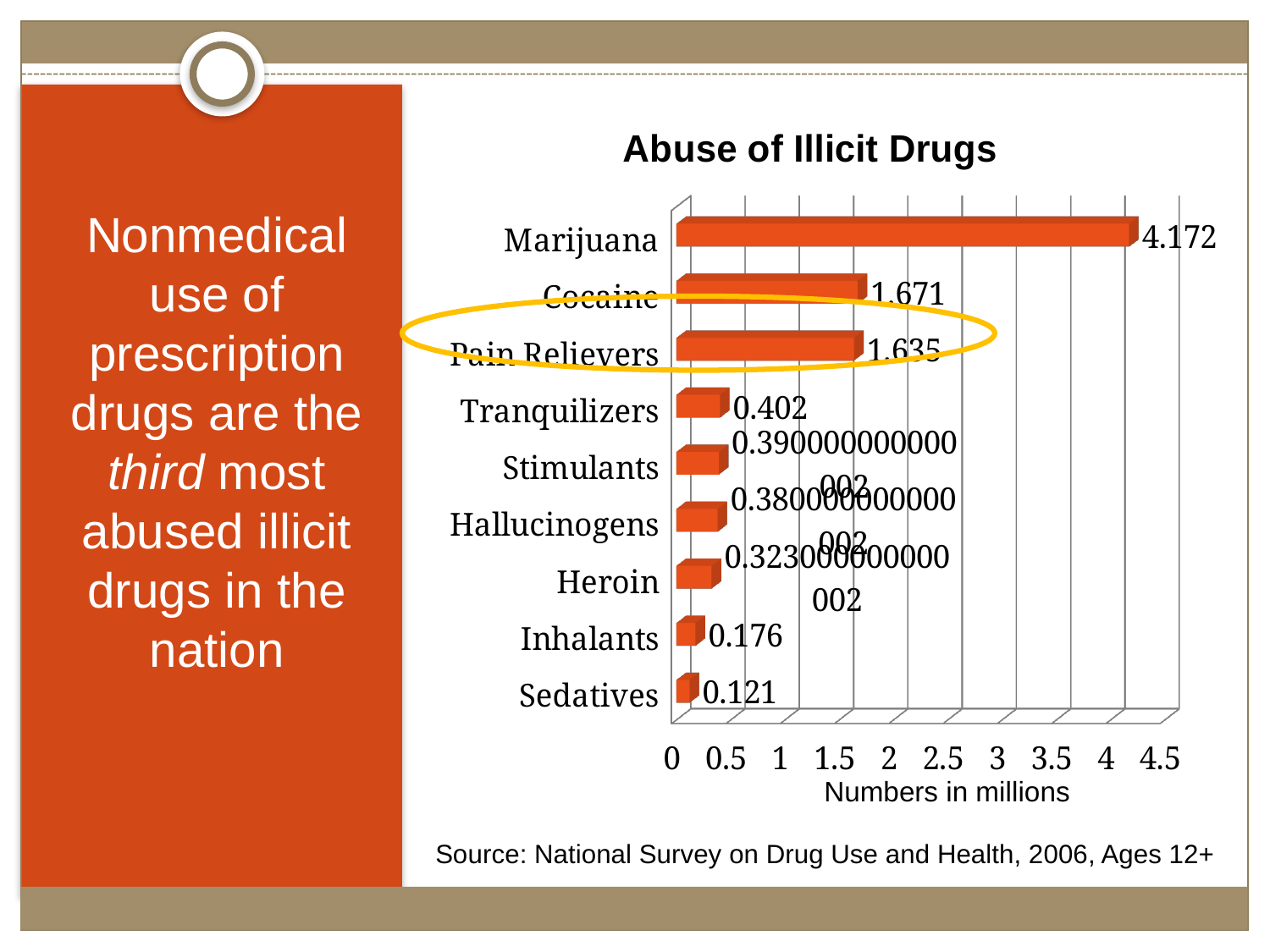
Is the value for Marijuana in the Abuse of Illicit Drugs chart greater or less than 4? greater Which category has the lowest value in the Abuse of Illicit Drugs chart? Sedatives What is the x-axis label of the Abuse of Illicit Drugs chart? Numbers in millions What kind of chart is the Abuse of Illicit Drugs chart? Bar chart What is the value for Marijuana in the Abuse of Illicit Drugs chart? 4.172 What is the difference between the values for Tranquilizers and Inhalants in the Abuse of Illicit Drugs chart? 0.226 How many categories are shown in the Abuse of Illicit Drugs chart? 9 What is the value for Sedatives in the Abuse of Illicit Drugs chart? 0.121 What is the value for Pain Relievers in the Abuse of Illicit Drugs chart? 1.635 What is the difference between the values for Marijuana and Cocaine in the Abuse of Illicit Drugs chart? 2.501 Which is larger in the Abuse of Illicit Drugs chart, the value for Cocaine or the value for Tranquilizers? Cocaine Which category has the highest value in the Abuse of Illicit Drugs chart? Marijuana